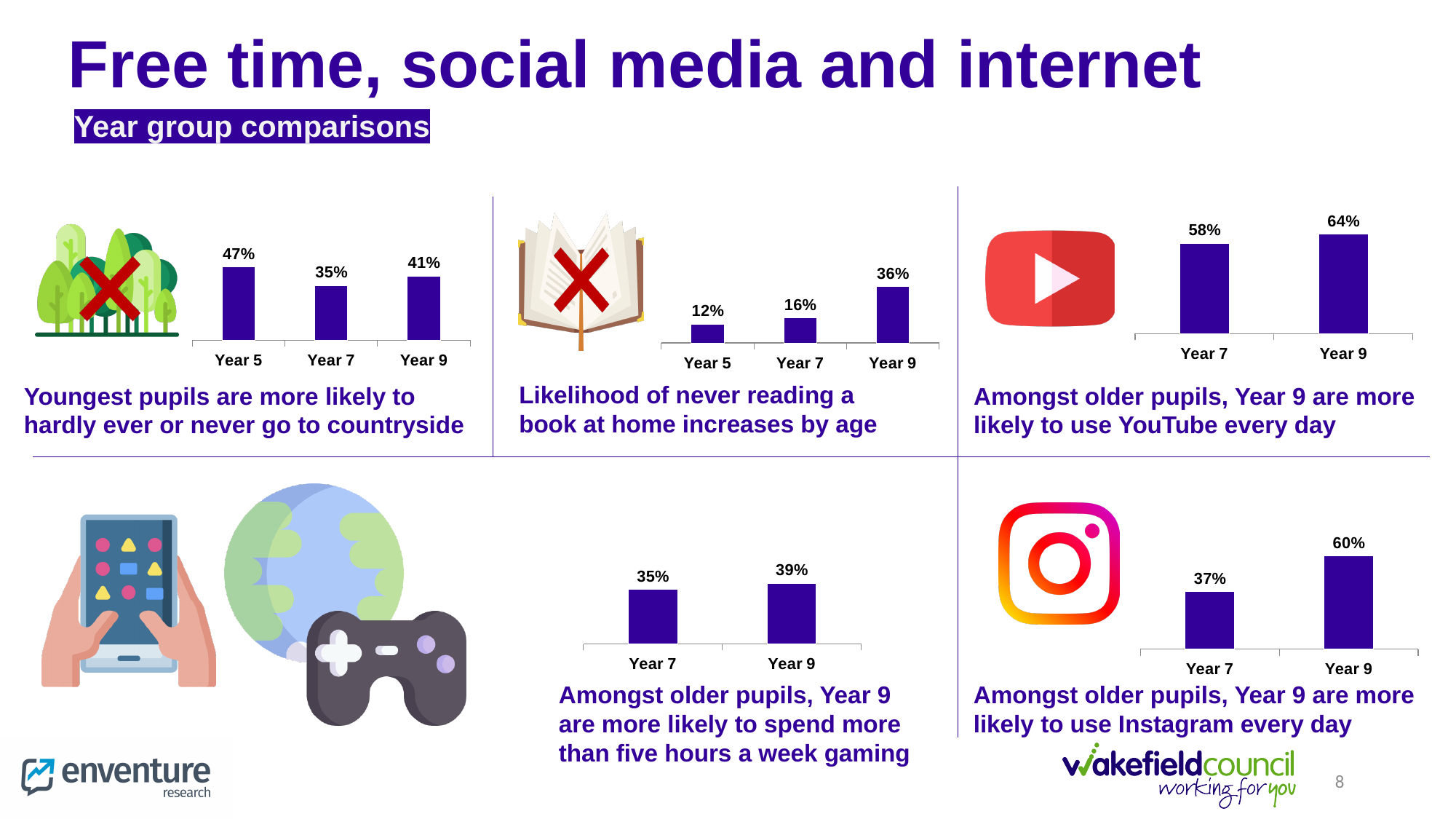
In the top-left chart about hardly ever or never going to the countryside, which year group has the lowest value? Year 7 In the top-left chart about hardly ever or never going to the countryside, what is the value for Year 5? 47% In the bottom-right chart about using Instagram every day, what is the difference between Year 9 and Year 7? 23 percentage points How many year groups are shown in the top-left chart about hardly ever or never going to the countryside? 3 In the top-middle chart about never reading a book at home, do the values rise or fall from Year 5 to Year 9? rise In the top-middle chart about never reading a book at home, what is the difference between Year 9 and Year 5? 24 percentage points In the bottom-middle chart about spending more than five hours a week gaming, what is the value for Year 7? 35% In the bottom-middle chart about spending more than five hours a week gaming, which year group has the higher value? Year 9 In the top-right chart about using YouTube every day, what is the value for Year 7? 58% In the top-right chart about using YouTube every day, what is the difference between Year 9 and Year 7? 6 percentage points In the top-middle chart about never reading a book at home, what is the value for Year 9? 36% In the bottom-right chart about using Instagram every day, what is the value for Year 9? 60%